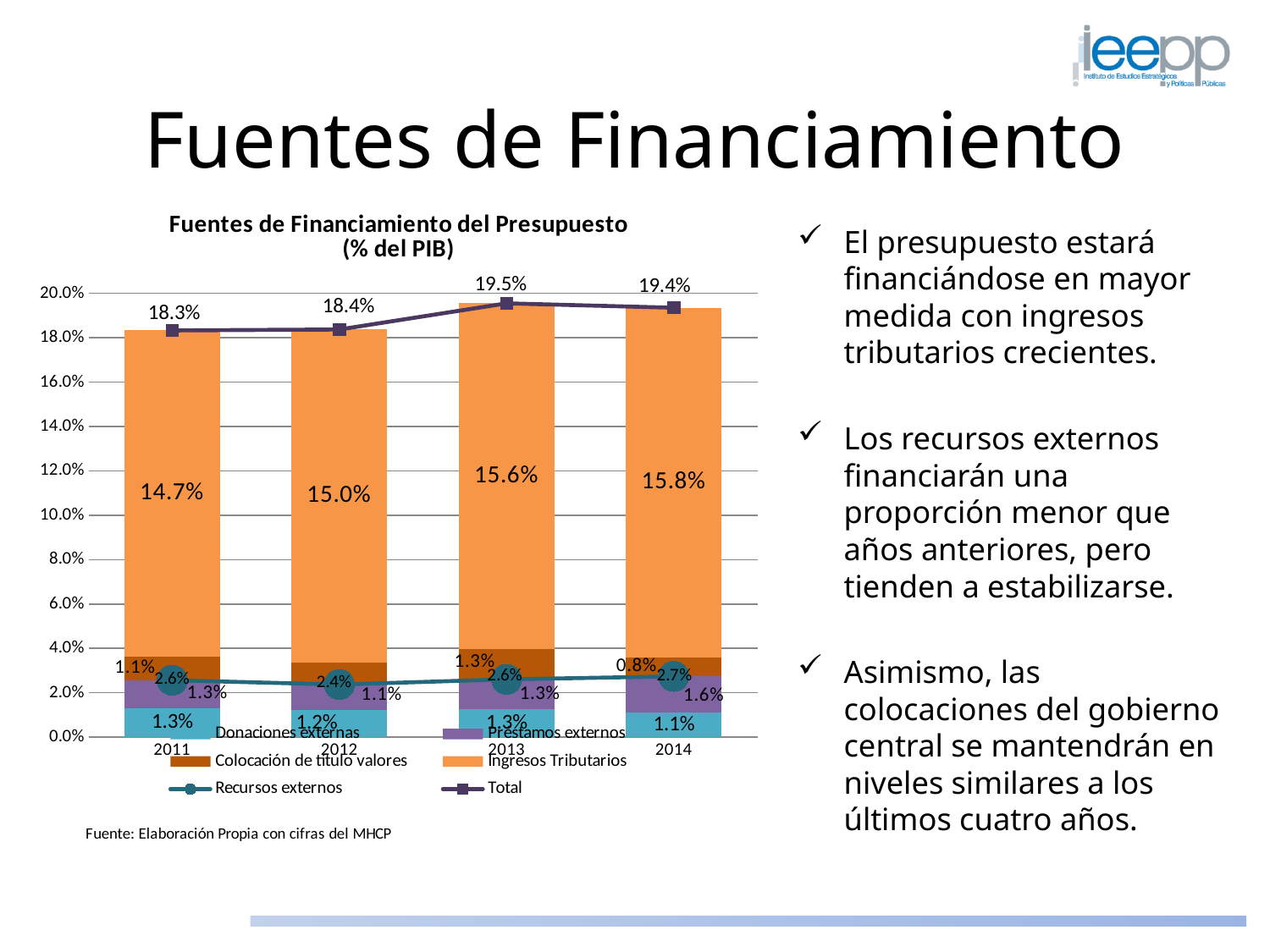
What is the Total value shown for 2013? 19.5% How many series does the legend list? 6 What is the difference between Ingresos Tributarios in 2014 and in 2011? 1.1% What is the value of Recursos externos for 2012? 2.4% What is the title of the chart? Fuentes de Financiamiento del Presupuesto (% del PIB) What is the value of Ingresos Tributarios for 2014? 15.8% In which year is the Total highest? 2013 Which is larger, the Total for 2012 or the Total for 2014? 2014 How many years are shown on the x axis? 4 What is the value of Préstamos externos for 2014? 1.6% What is the value of Donaciones externas for 2011? 1.3% In which year is Ingresos Tributarios lowest? 2011